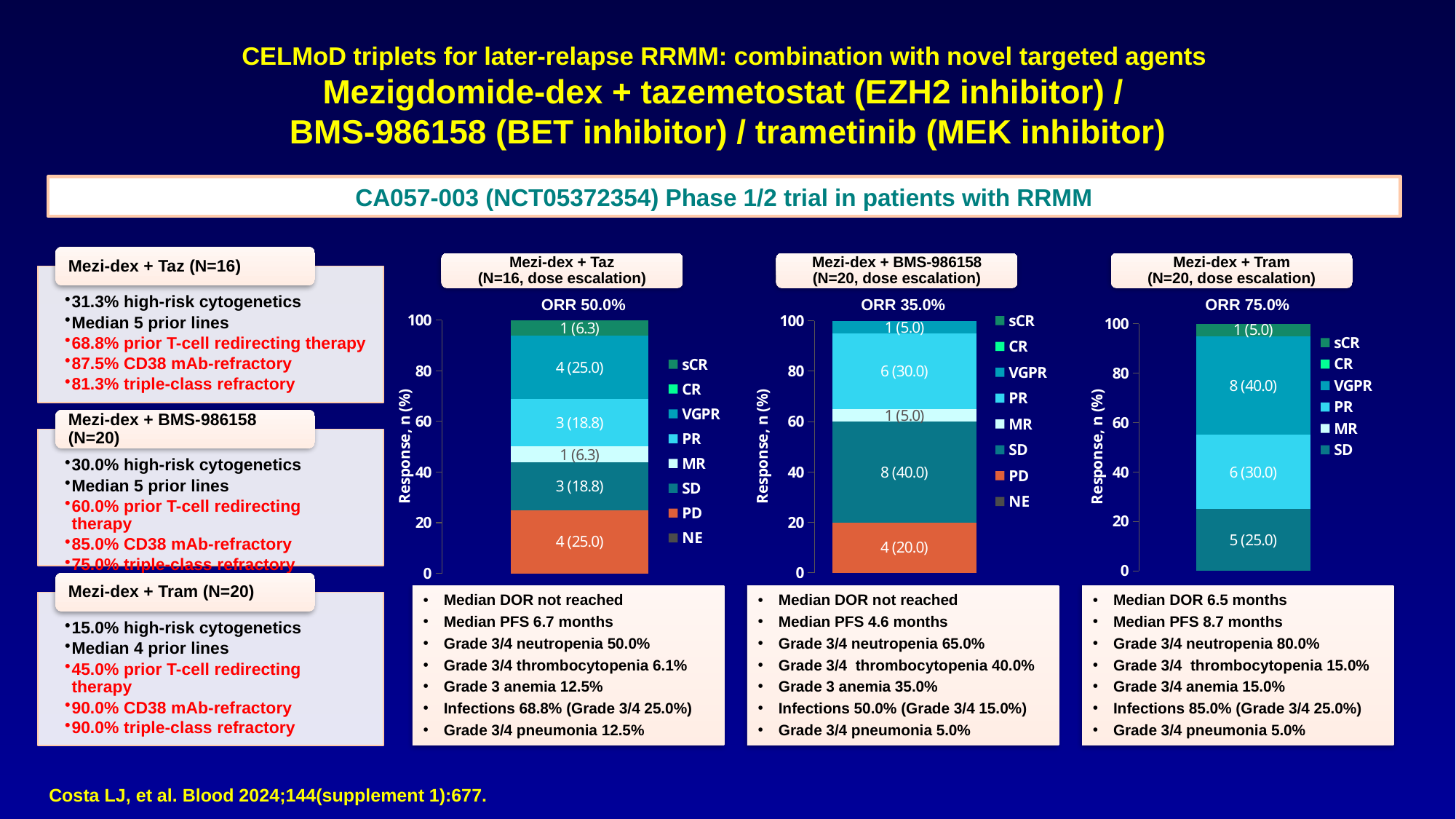
In the Mezi-dex + BMS-986158 chart, which response category has the largest segment? SD How many entries does the legend of the Mezi-dex + Taz chart list? 8 In the Mezi-dex + BMS-986158 chart, which is larger: the PR segment or the PD segment? PR In the Mezi-dex + Tram chart, which response category has the smallest segment? sCR In the Mezi-dex + BMS-986158 chart, what is the value shown for the SD segment? 8 (40.0) In the Mezi-dex + Taz chart, how many more patients had PD than MR? 3 In the Mezi-dex + Tram chart, what is the value shown for the VGPR segment? 8 (40.0) How many entries does the legend of the Mezi-dex + Tram chart list? 6 What type of chart is used to show the response data for Mezi-dex + BMS-986158? Stacked bar chart In the Mezi-dex + Tram chart, what is the value shown for the sCR segment? 1 (5.0) What ORR is shown above the Mezi-dex + Tram chart? ORR 75.0% In the Mezi-dex + Taz chart, what is the value shown for the PD segment? 4 (25.0)